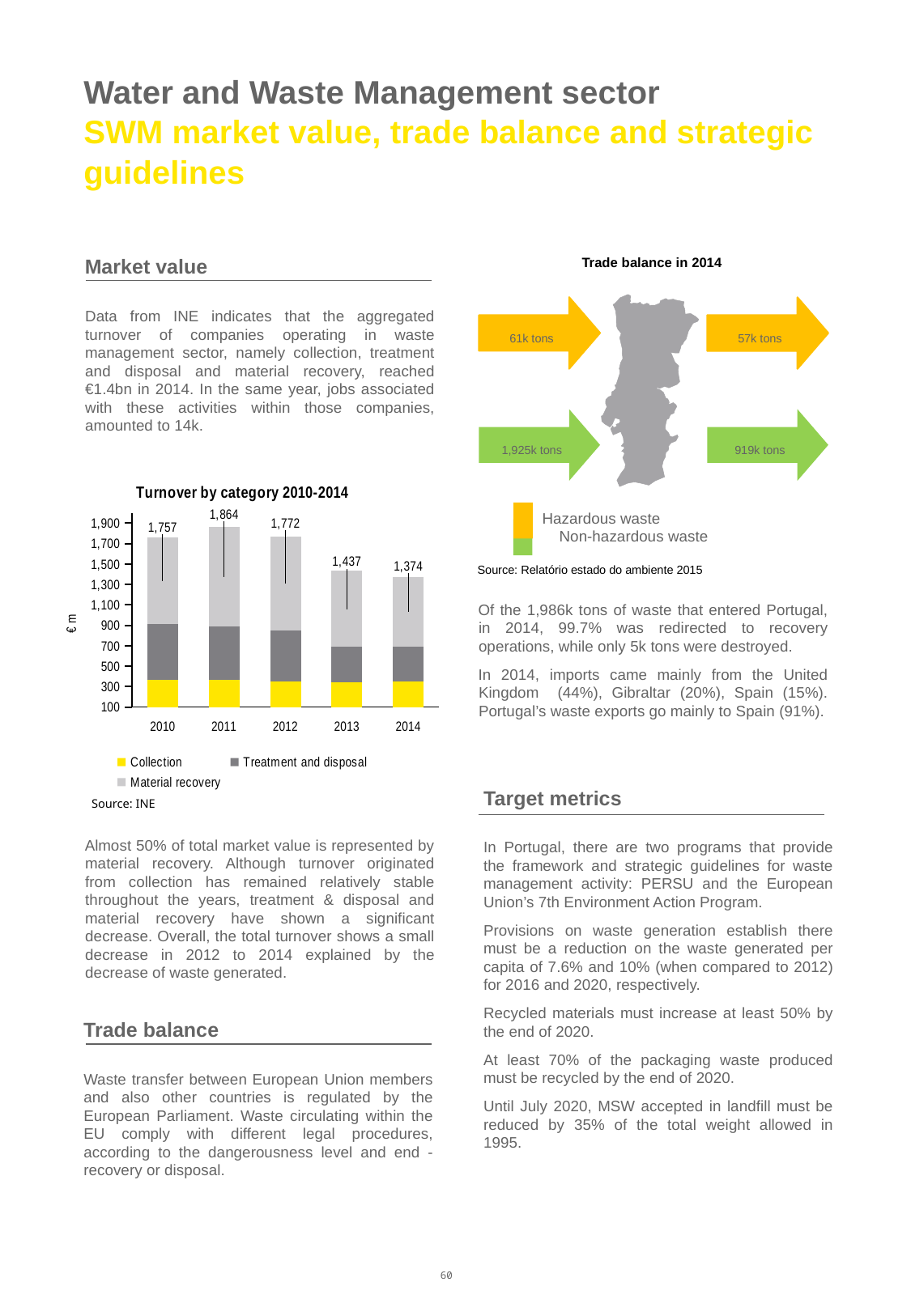
How many series does the legend of the 'Turnover by category 2010-2014' chart list? 3 In the 'Turnover by category 2010-2014' chart, which year has the larger total turnover, 2010 or 2012? 2012 By how much did total turnover fall from 2012 to 2013 in the 'Turnover by category 2010-2014' chart? 335 In the 'Turnover by category 2010-2014' chart, is the Collection value for 2010 greater or less than 500? less What is the total turnover shown for 2014 in the 'Turnover by category 2010-2014' chart? 1,374 What is the total turnover shown for 2011 in the 'Turnover by category 2010-2014' chart? 1,864 What is the total of the stacked bar for 2013 in the 'Turnover by category 2010-2014' chart? 1,437 What kind of chart is 'Turnover by category 2010-2014'? Stacked bar chart Which year has the lowest total turnover in the 'Turnover by category 2010-2014' chart? 2014 Which year has the highest total turnover in the 'Turnover by category 2010-2014' chart? 2011 How many years are shown on the x axis of the 'Turnover by category 2010-2014' chart? 5 What is the difference between the total turnover in 2011 and in 2014 in the 'Turnover by category 2010-2014' chart? 490